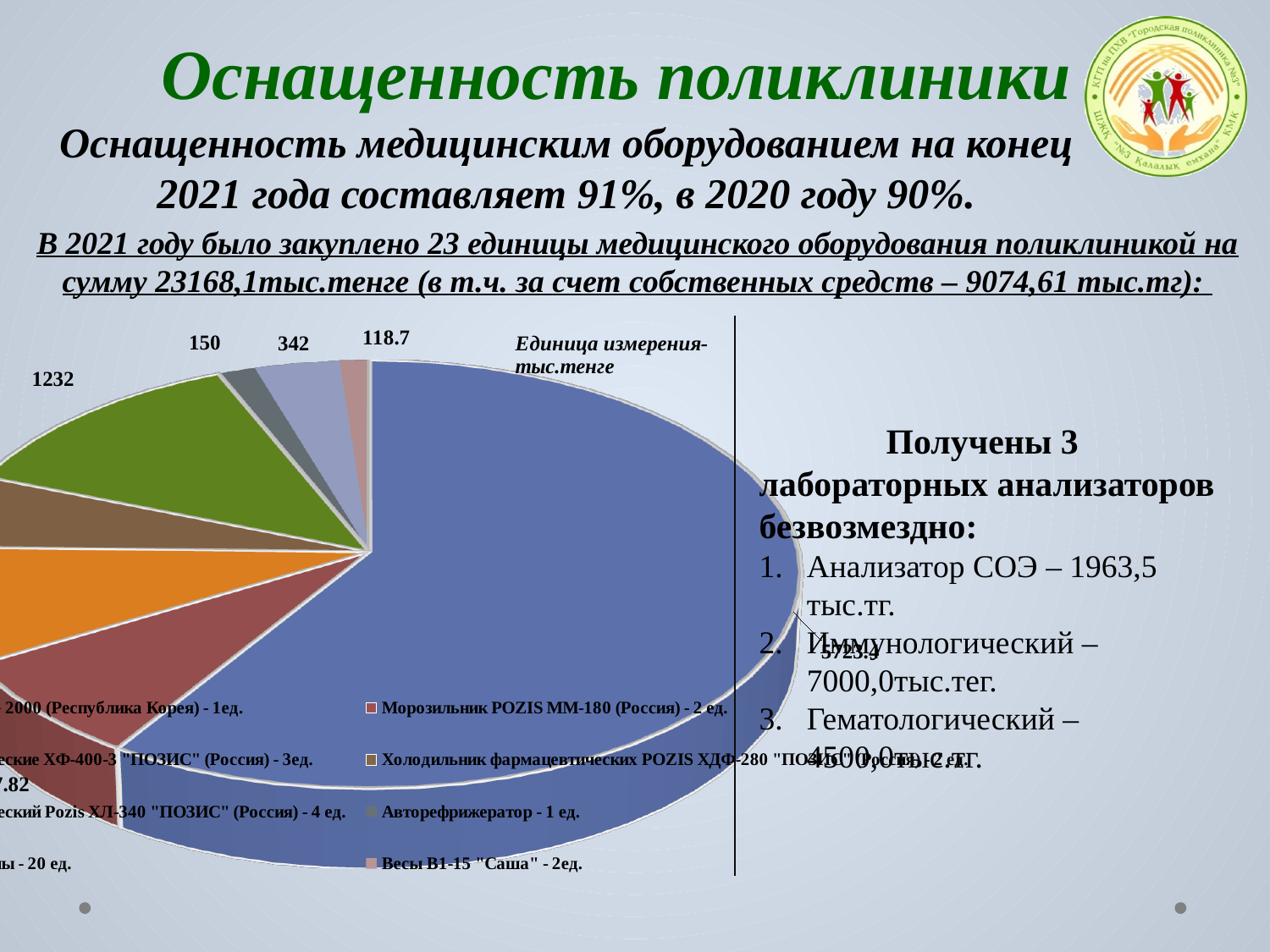
What colour is the largest slice of the pie? blue Which legend entry corresponds to the smallest slice of the pie? Весы В1-15 "Саша" - 2ед. What is the value for the Pozis ХЛ-340 "ПОЗИС" (Россия) - 4 ед. slice? 1232 What kind of chart is shown on the slide? pie chart Which is larger, the value for Авторефрижератор - 1 ед. or for Весы В1-15 "Саша" - 2ед.? Авторефрижератор - 1 ед. What is the difference between the value for Авторефрижератор - 1 ед. and the value for Весы В1-15 "Саша" - 2ед.? 31.3 What unit of measurement is stated on the chart? тыс.тенге How many entries does the chart legend list? 8 What is the value for Авторефрижератор - 1 ед.? 150 What is the value for Весы В1-15 "Саша" - 2ед.? 118.7